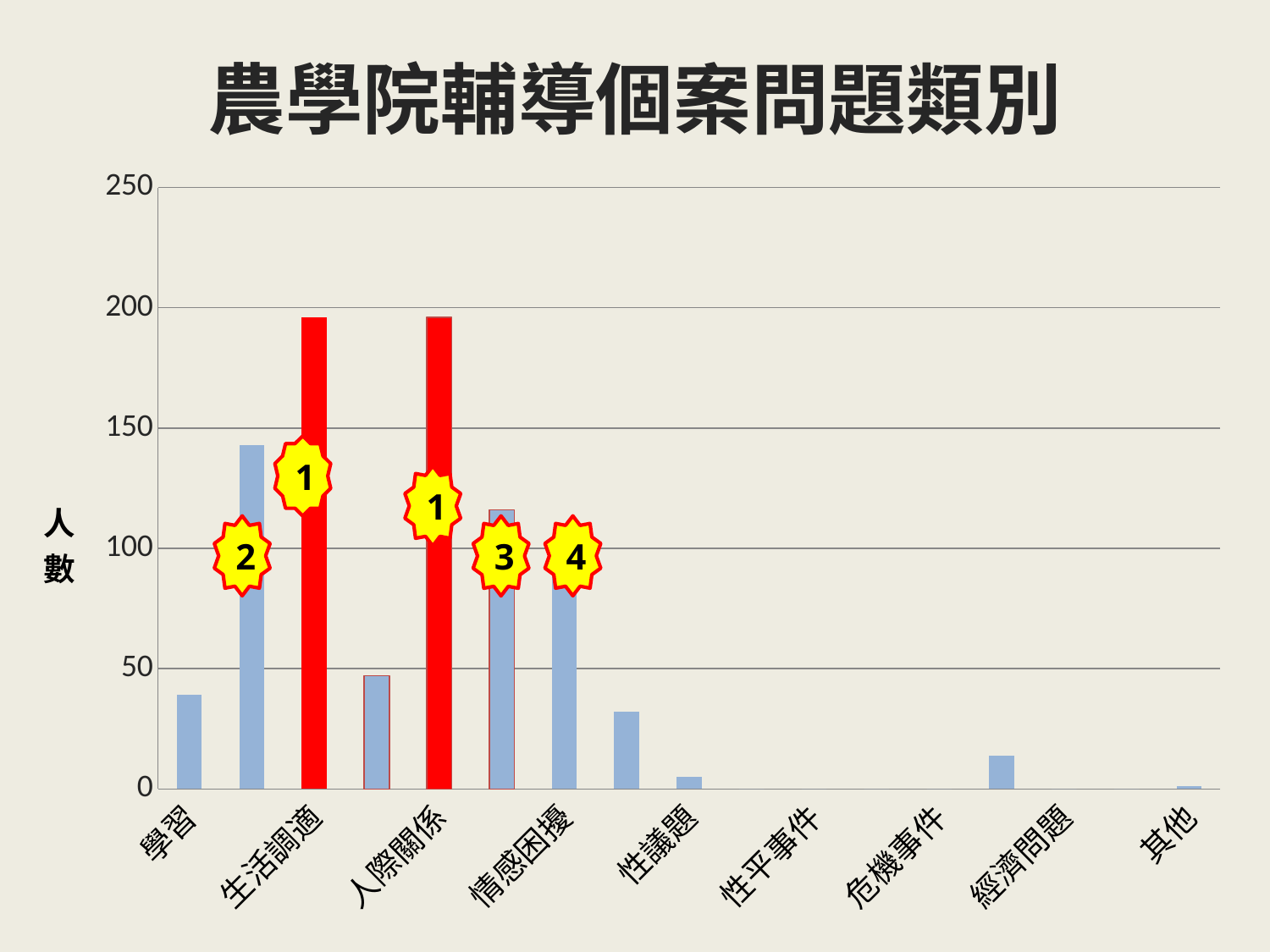
Is the value of the left (blue) bar for 生活調適 greater or less than 100? greater What is the label on the vertical axis of the chart? 人數 Which is larger: the blue bar for 生活調適 or the blue bar for 情感困擾? 生活調適 Is the value of the left (blue) bar for 情感困擾 greater or less than 100? greater How many categories are shown on the x axis of the chart? 9 Is the value for 經濟問題 greater or less than 50? less What is the title of the chart? 農學院輔導個案問題類別 What kind of chart is shown on the slide? bar chart